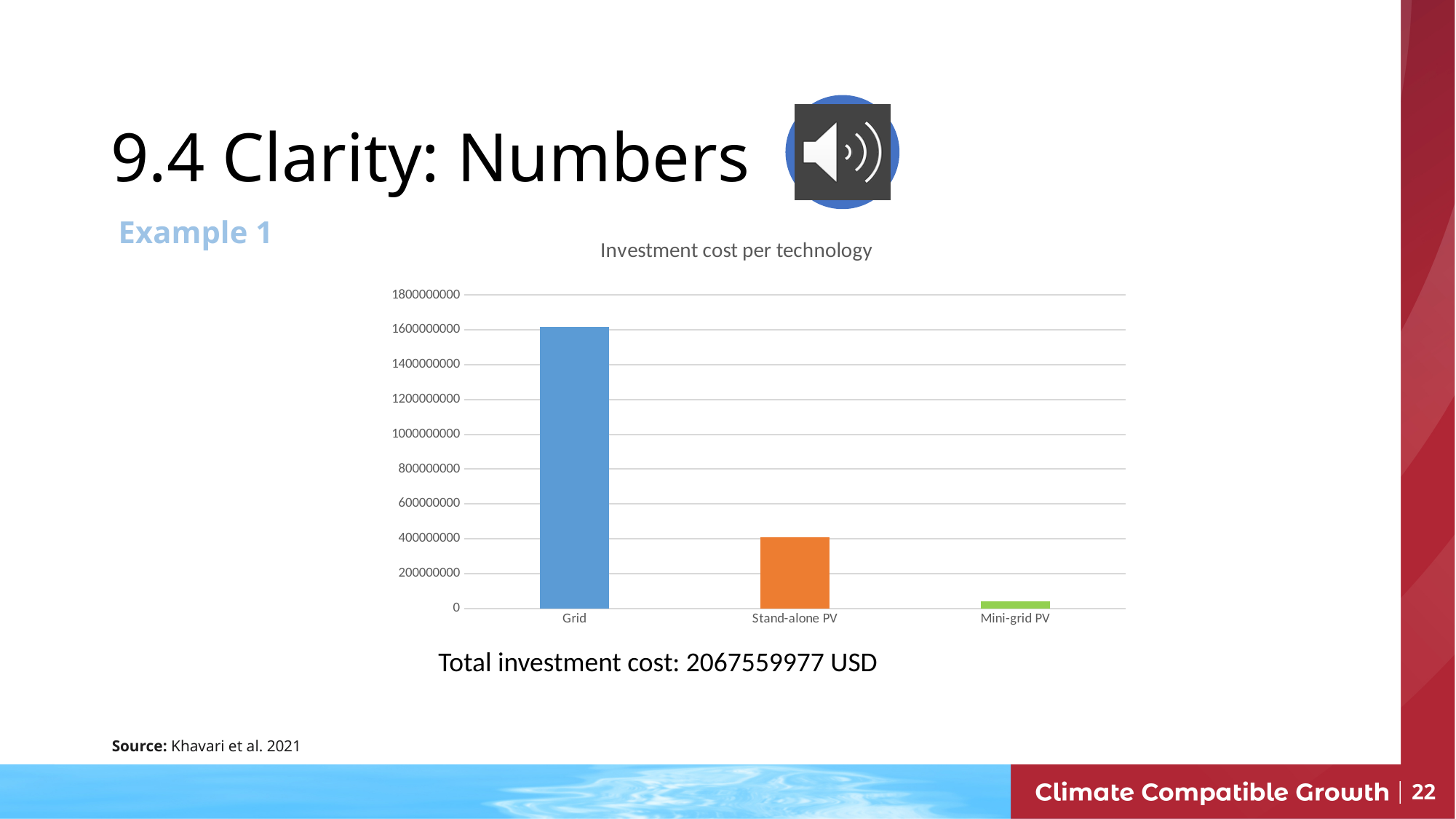
Which technology has the lowest investment cost? Mini-grid PV Is the investment cost for Grid greater or less than 1400000000? greater How many categories are shown on the x axis of the chart? 3 Is the investment cost for Mini-grid PV greater or less than 200000000? less Which technology has the highest investment cost? Grid What colour is the bar for Stand-alone PV? orange Which has a larger investment cost, Stand-alone PV or Mini-grid PV? Stand-alone PV Is the investment cost for Stand-alone PV greater or less than 600000000? less What is the total investment cost stated below the chart? 2067559977 USD What kind of chart is shown on the slide? bar chart Do the investment costs rise or fall from left to right across the categories? fall What is the title of the chart? Investment cost per technology